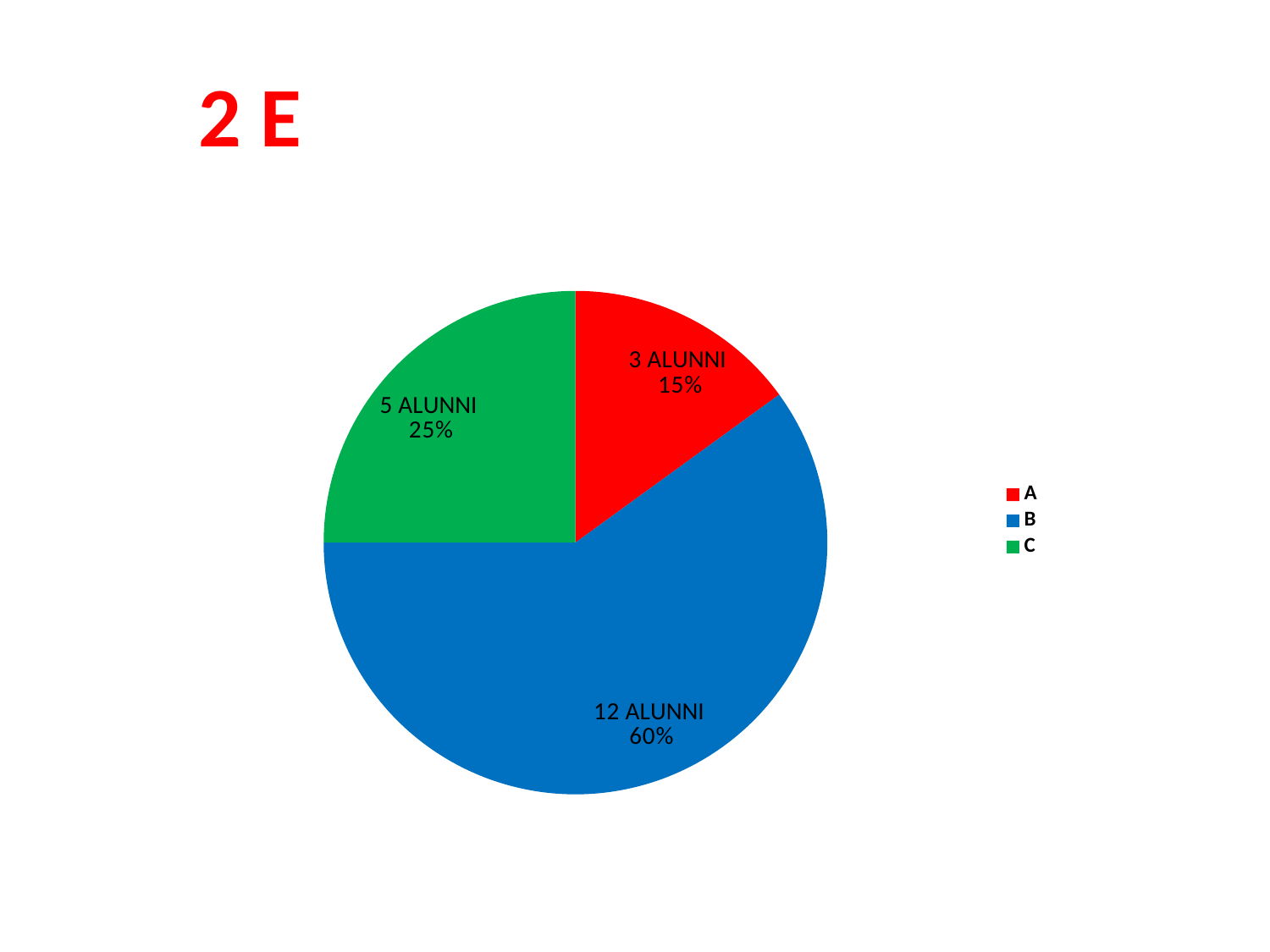
What percentage share does slice B have? 60% What is the difference in percentage points between slice B and slice C? 35% How many entries does the legend list? 3 How many slices does the pie chart have? 3 What percentage share does slice C have? 25% What kind of chart is shown on the slide? pie chart Which category has the largest slice? B Which category has the smallest slice? A What percentage share does slice A have? 15% How many alunni are in category B? 12 ALUNNI Which colour represents category C in the legend? green How many alunni are in category C? 5 ALUNNI